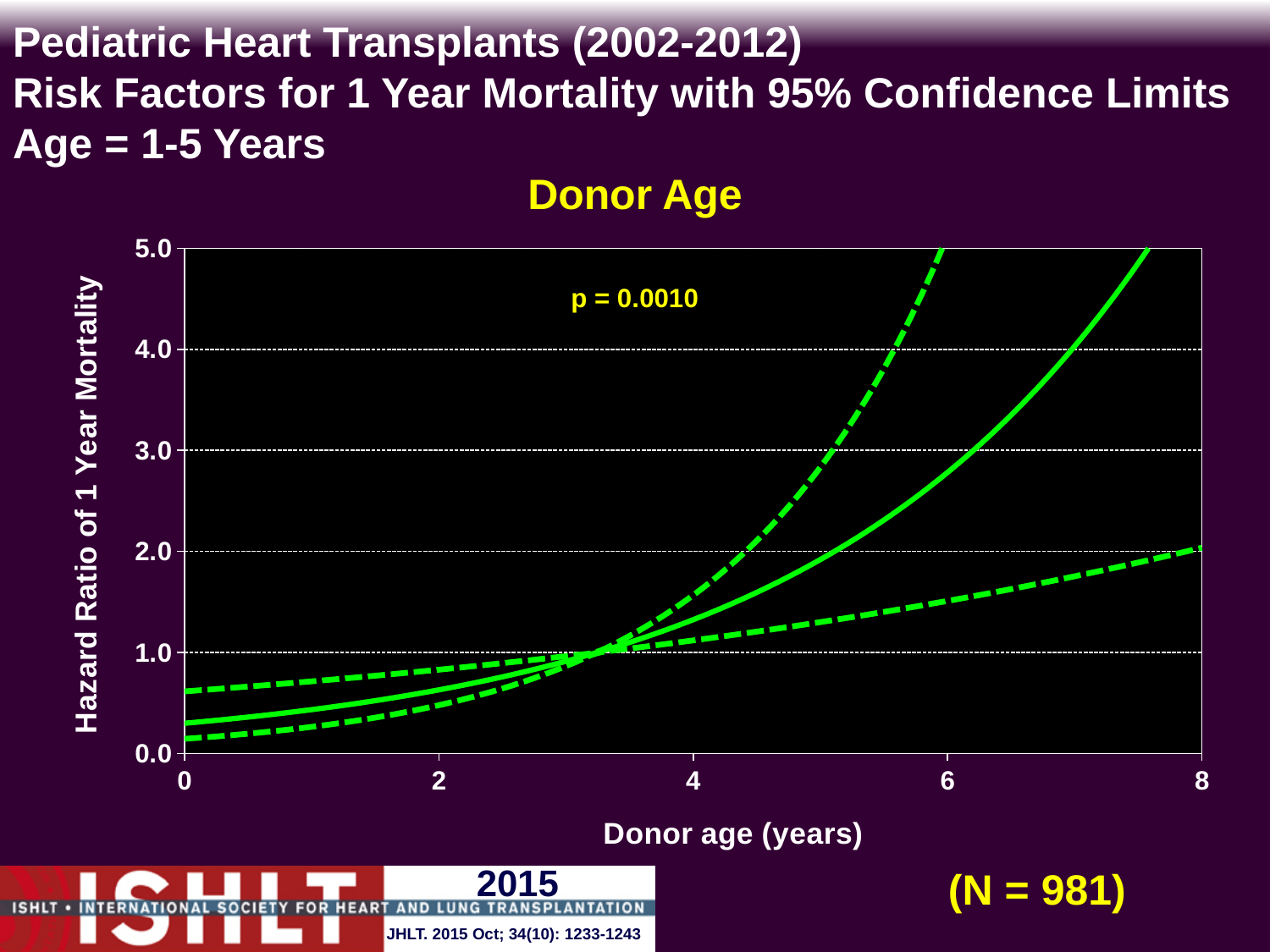
Is the hazard ratio (solid line) at a donor age of 8 years greater or less than 4.0? greater What p-value is printed on the chart? p = 0.0010 Is the hazard ratio (solid line) at a donor age of 6 years greater or less than 2.0? greater What type of chart is shown on the slide? line chart Is the hazard ratio (solid line) at a donor age of 0 years greater or less than 1.0? less Does the solid hazard ratio line rise or fall as donor age increases from 0 to 8 years? rise What is the label of the x axis? Donor age (years) How many lines are plotted on the chart? 3 What is the title of the chart? Donor Age What sample size (N) is printed on the slide? N = 981